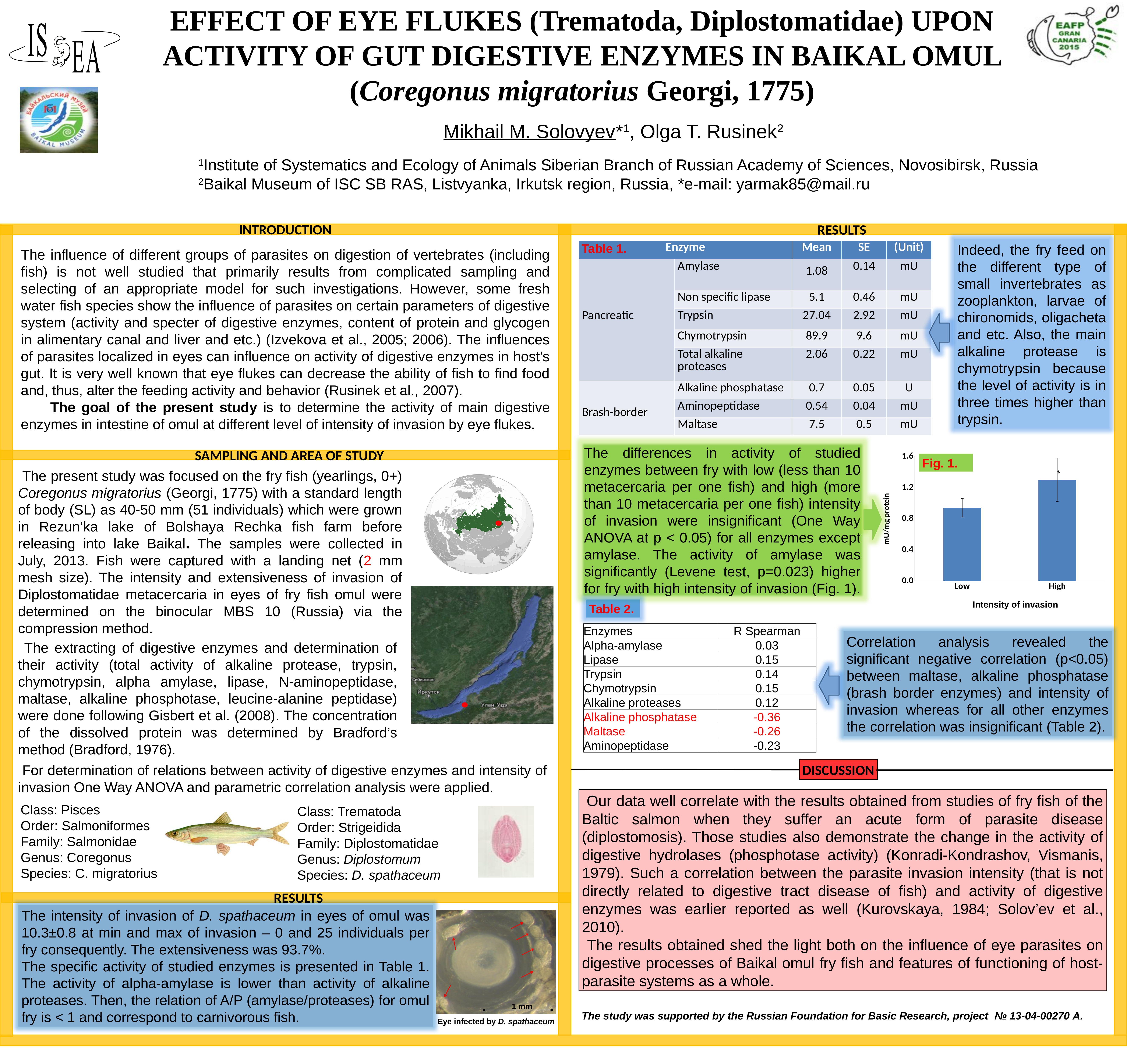
In Fig. 1, is the value for Low greater or less than 1.2? less In Fig. 1, which intensity of invasion category has the higher bar? High How many bars are plotted in Fig. 1? 2 In Fig. 1, is the value for Low greater or less than 0.8? greater What kind of chart is Fig. 1 on the slide? bar chart What is the x-axis label of Fig. 1? Intensity of invasion In Fig. 1, is the value for High greater or less than 0.8? greater In Fig. 1, is the bar for Low larger or smaller than the bar for High? smaller In Fig. 1, which intensity of invasion category has the lower bar? Low What is the y-axis label of Fig. 1? mU/mg protein Do the bar values in Fig. 1 rise or fall from Low to High intensity of invasion? rise